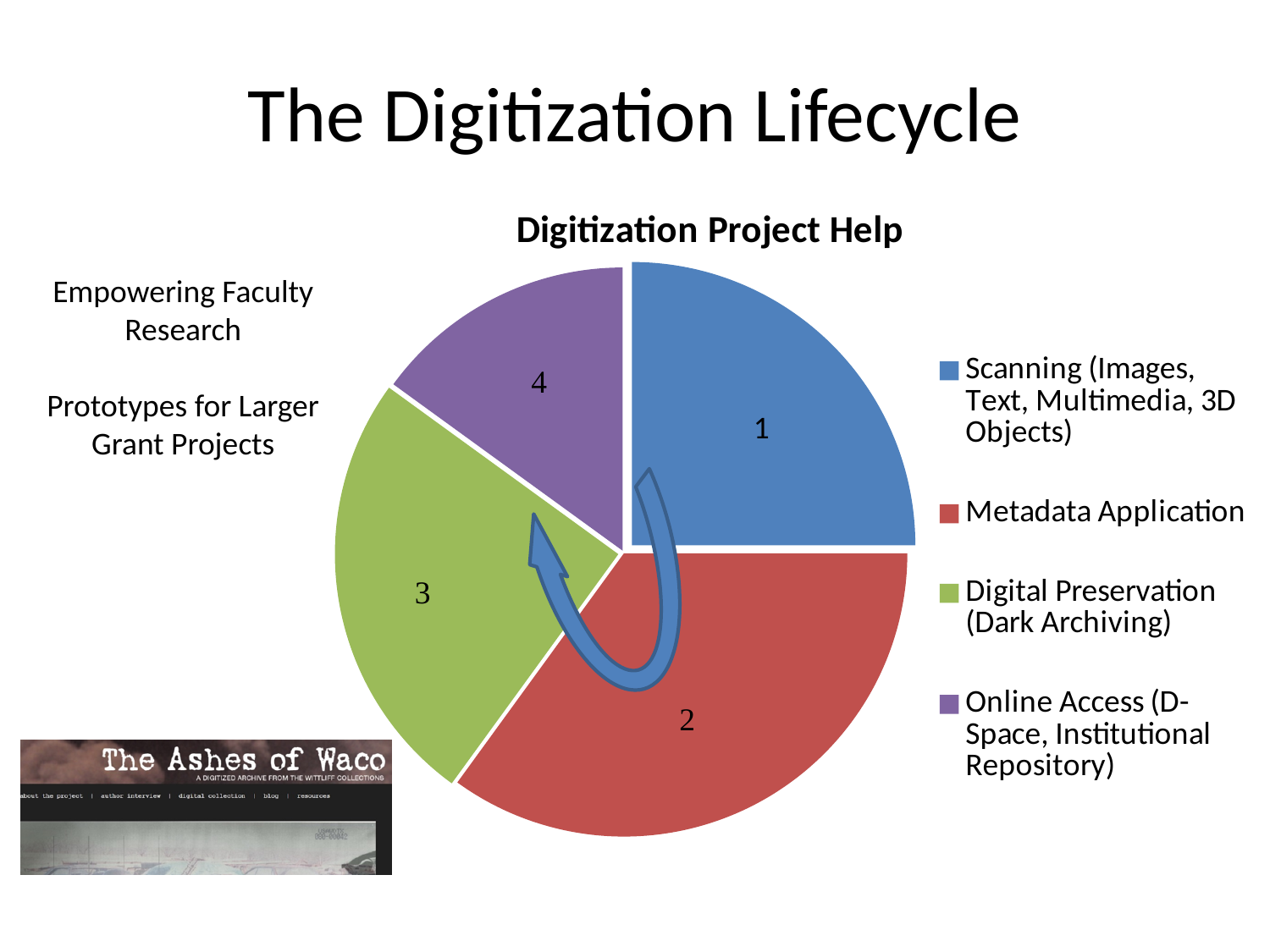
What colour is the Metadata Application slice? red What kind of chart is shown on the slide? pie chart How many slices does the pie chart have? 4 Which slice is larger: Metadata Application or Online Access (D-Space, Institutional Repository)? Metadata Application What is the title of the chart? Digitization Project Help What number is printed on the slice for Digital Preservation (Dark Archiving)? 3 Which category has the smallest slice of the pie? Online Access (D-Space, Institutional Repository) Which slice is larger: Digital Preservation (Dark Archiving) or Online Access (D-Space, Institutional Repository)? Digital Preservation (Dark Archiving) Which category has the largest slice of the pie? Metadata Application How many entries does the chart legend list? 4 What number is printed on the slice for Scanning (Images, Text, Multimedia, 3D Objects)? 1